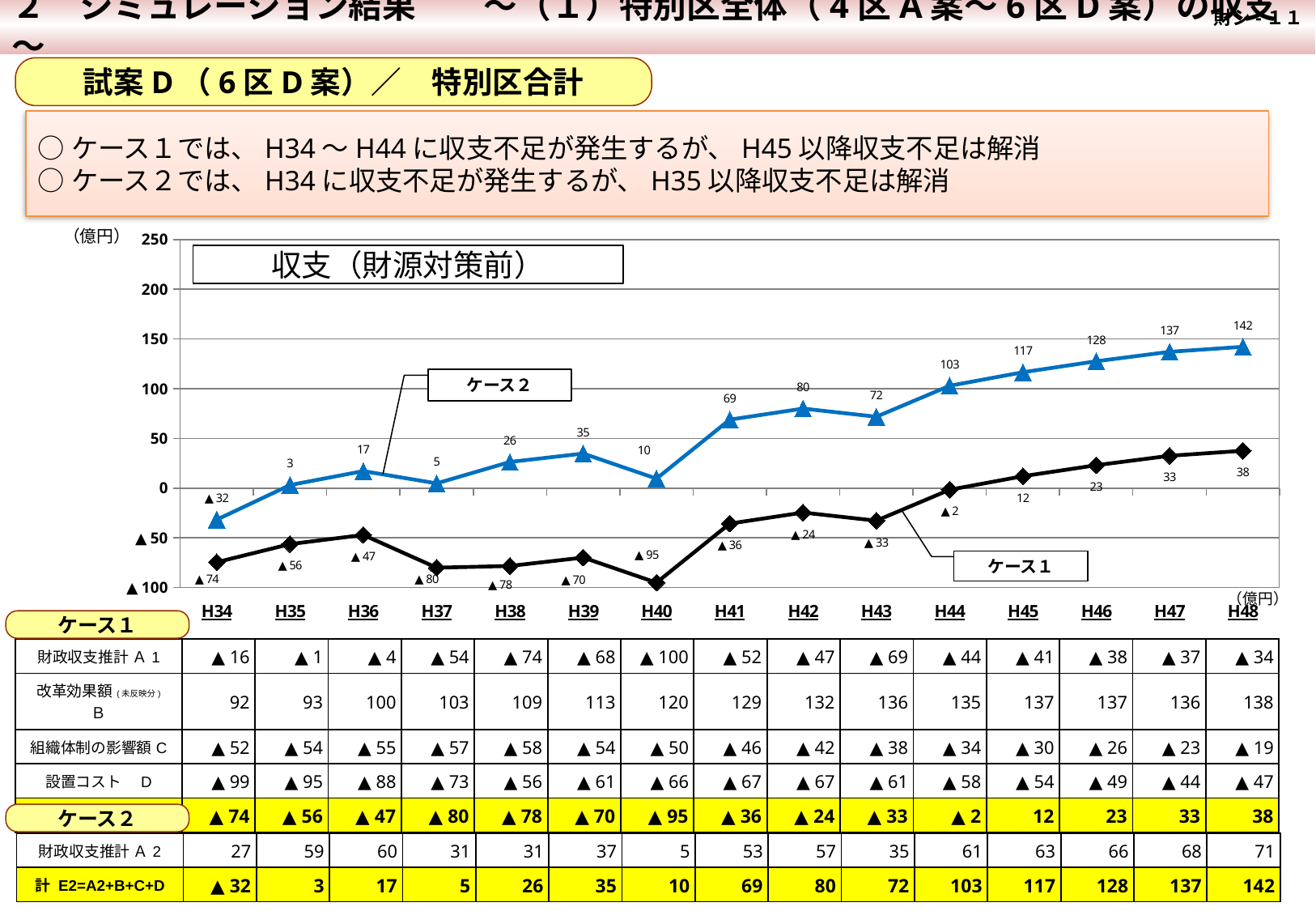
Which series has the larger value at H42, ケース1 or ケース2? ケース2 What type of chart is shown on the slide? line chart How many series are plotted in the chart? 2 How many years (data points) are plotted along the x axis of the chart? 15 What is the difference between ケース2 and ケース1 at H48 in the chart? 104 Does the value of ケース2 rise or fall from H44 to H48 in the chart? rise What is the value of ケース2 at H34 in the chart? ▲32 What is the value of ケース1 at H40 in the chart? ▲95 What is the title shown inside the chart? 収支（財源対策前） In which year does ケース1 reach its lowest value in the chart? H40 What is the value of ケース2 at H44 in the chart? 103 In which year does ケース2 reach its highest value in the chart? H48